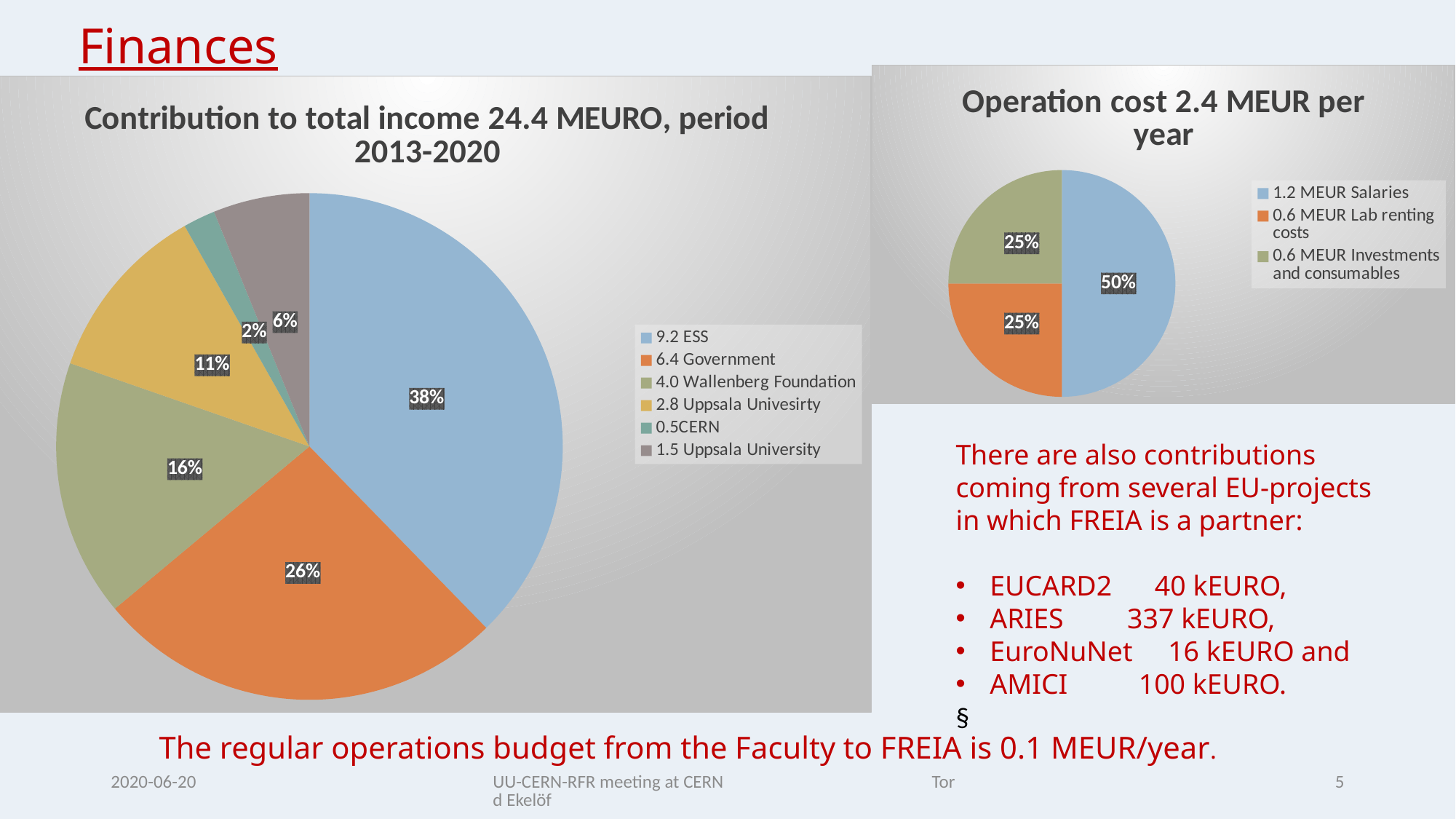
What kind of chart is the 'Contribution to total income 24.4 MEURO, period 2013-2020' chart? pie chart In the 'Contribution to total income' pie chart, what share is labelled for the ESS slice? 38% In the 'Contribution to total income' pie chart, which is larger, the Wallenberg Foundation slice or the Uppsala Univesirty slice? Wallenberg Foundation In the 'Operation cost 2.4 MEUR per year' pie chart, what share is labelled for Salaries? 50% In the 'Contribution to total income' pie chart, which legend entry has the smallest slice? 0.5CERN In the 'Contribution to total income' pie chart, what share is labelled for the Government slice? 26% In the 'Contribution to total income' pie chart, which legend entry has the largest slice? 9.2 ESS In the 'Contribution to total income' pie chart, how many slices are there? 6 In the 'Operation cost 2.4 MEUR per year' pie chart, how many legend entries are listed? 3 In the 'Contribution to total income' pie chart, what is the difference in percentage points between the ESS slice and the Government slice? 12 In the 'Operation cost 2.4 MEUR per year' pie chart, what colour is the Salaries slice? blue